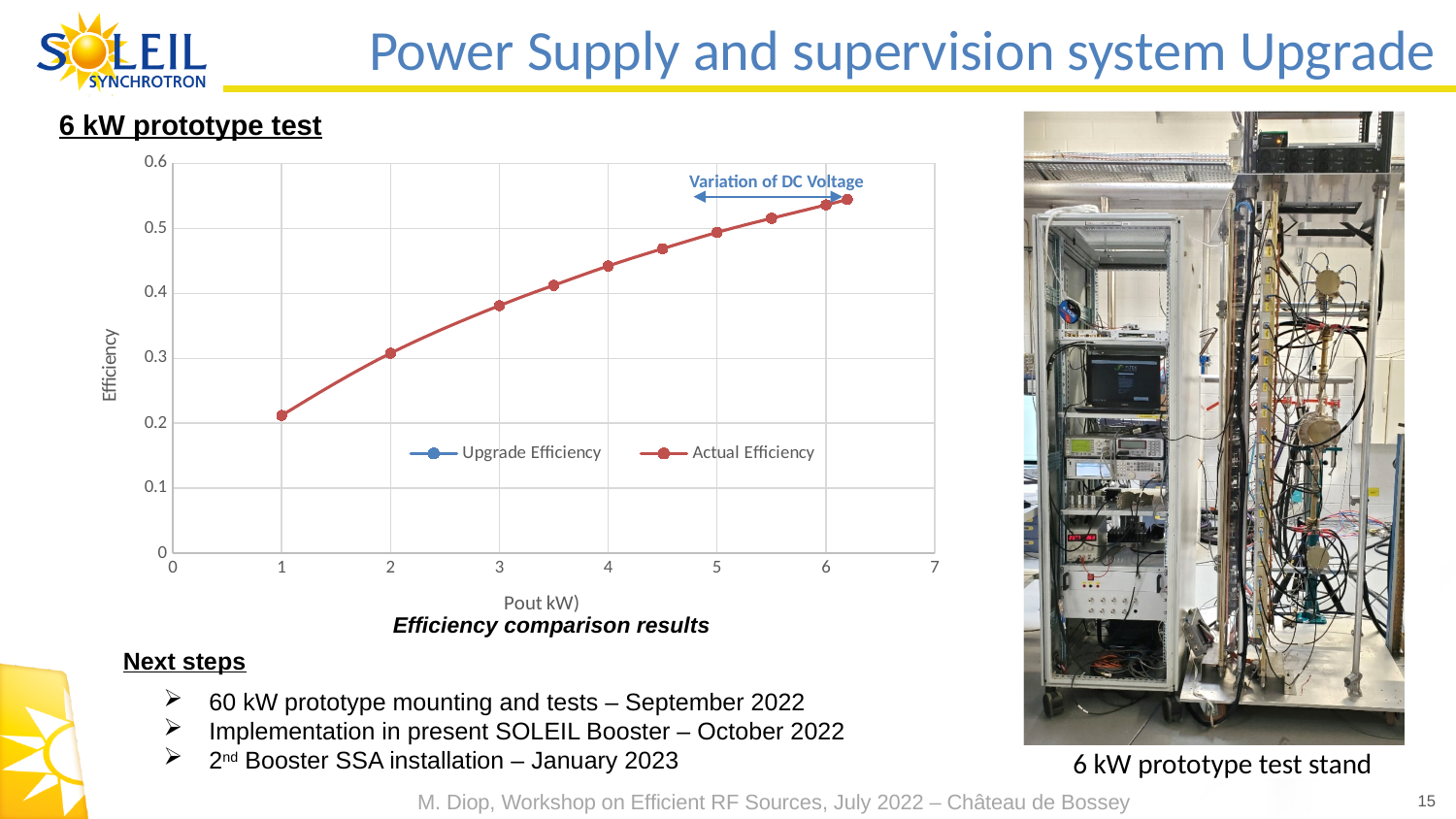
What kind of chart is shown under "6 kW prototype test"? line chart Is the Actual Efficiency at 4 kW greater or less than 0.4? greater What are the two series named in the legend of the efficiency chart? Upgrade Efficiency and Actual Efficiency Which series is plotted in red on the efficiency chart? Actual Efficiency Is the Actual Efficiency at 6 kW greater or less than 0.5? greater How many series does the legend of the efficiency chart list? 2 What is the maximum value shown on the y axis of the efficiency chart? 0.6 Does the Actual Efficiency rise or fall as Pout increases along the x axis? rises Is the Actual Efficiency at 1 kW greater or less than 0.3? less Which is larger, the Actual Efficiency at 2 kW or at 5 kW? at 5 kW